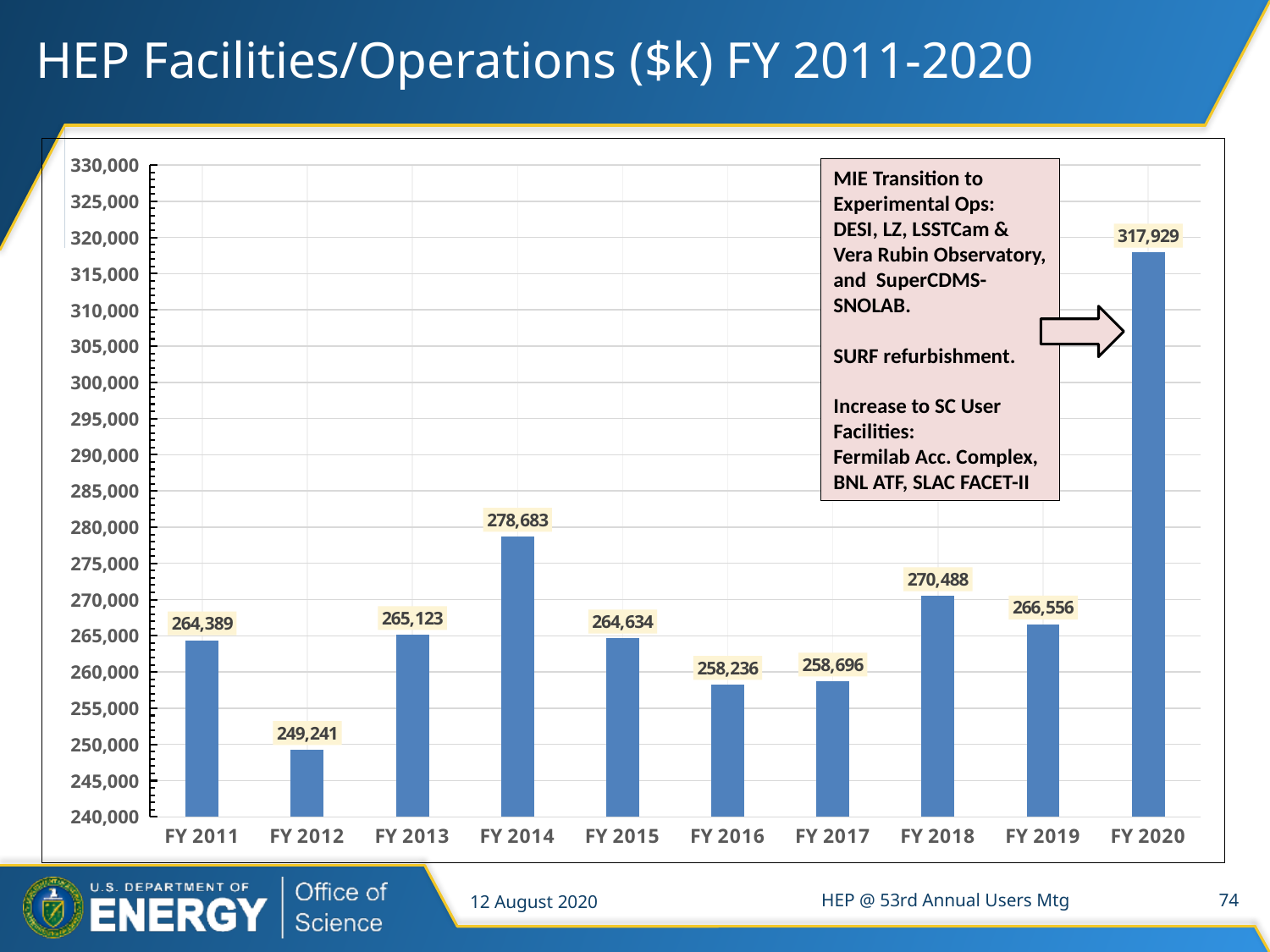
Which fiscal year has the lowest value? FY 2012 What is the value for FY 2012? 249,241 What is the title of the chart? HEP Facilities/Operations ($k) FY 2011-2020 What is the value for FY 2014? 278,683 Which fiscal year has the highest value? FY 2020 How many fiscal years are shown on the x axis? 10 What kind of chart is shown on the slide? bar chart Is the value for FY 2016 greater or less than 260,000? less What is the difference between the FY 2020 value and the FY 2019 value? 51,373 What is the value for FY 2020? 317,929 Which is larger, the value for FY 2018 or the value for FY 2019? FY 2018